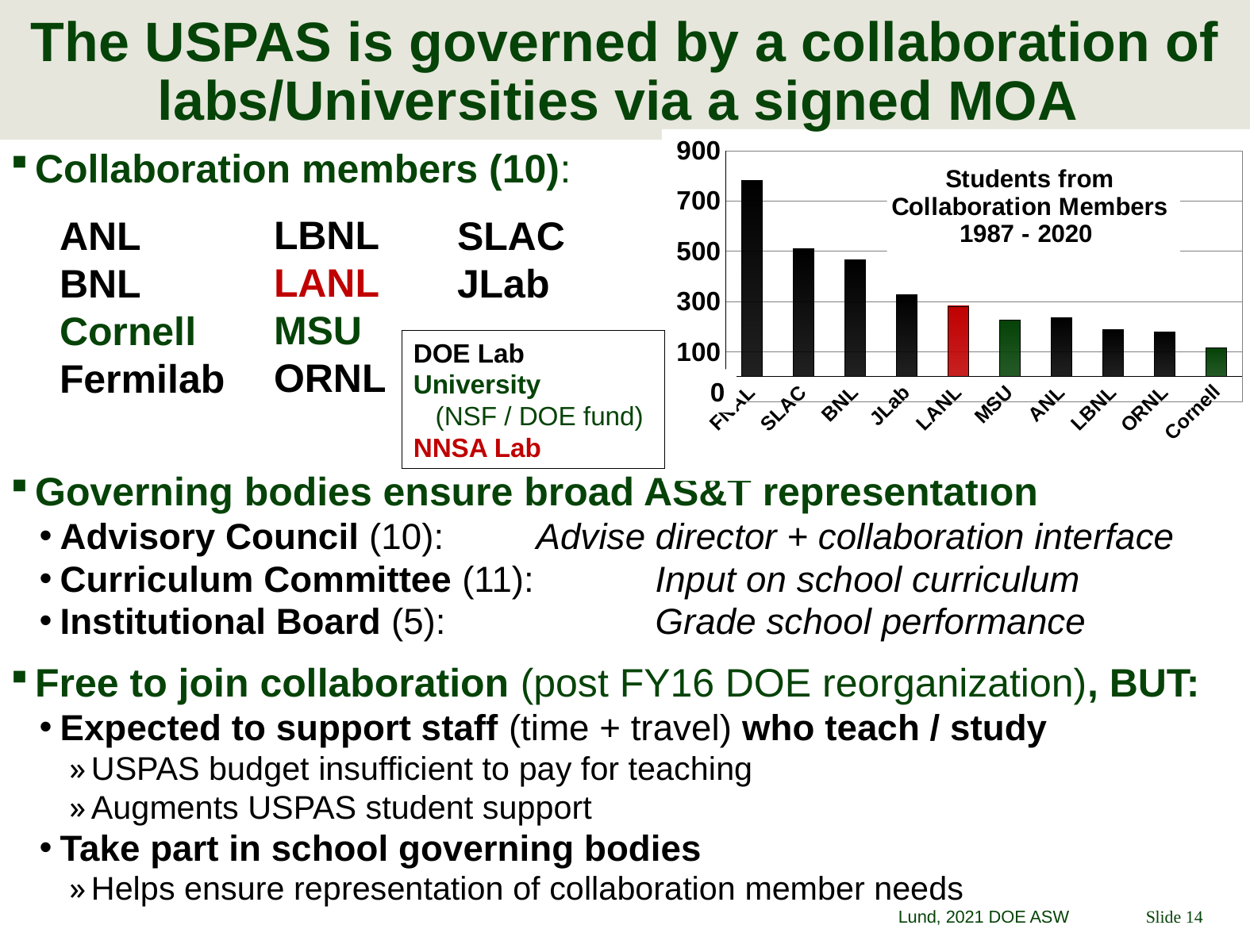
Is the value for SLAC greater or less than 300? greater What is the title of the chart? Students from Collaboration Members 1987 - 2020 Is the value for LBNL greater or less than 300? less Do the bar values generally rise or fall from left to right across the chart? fall Which institution has the lowest bar in the chart? Cornell How many institutions are shown as bars in the chart? 10 What colour is the bar for LANL? red Is the value for BNL greater or less than 500? less Which has the larger value, SLAC or BNL? SLAC Which has the larger value, JLab or LANL? JLab What kind of chart is shown on the slide? bar chart